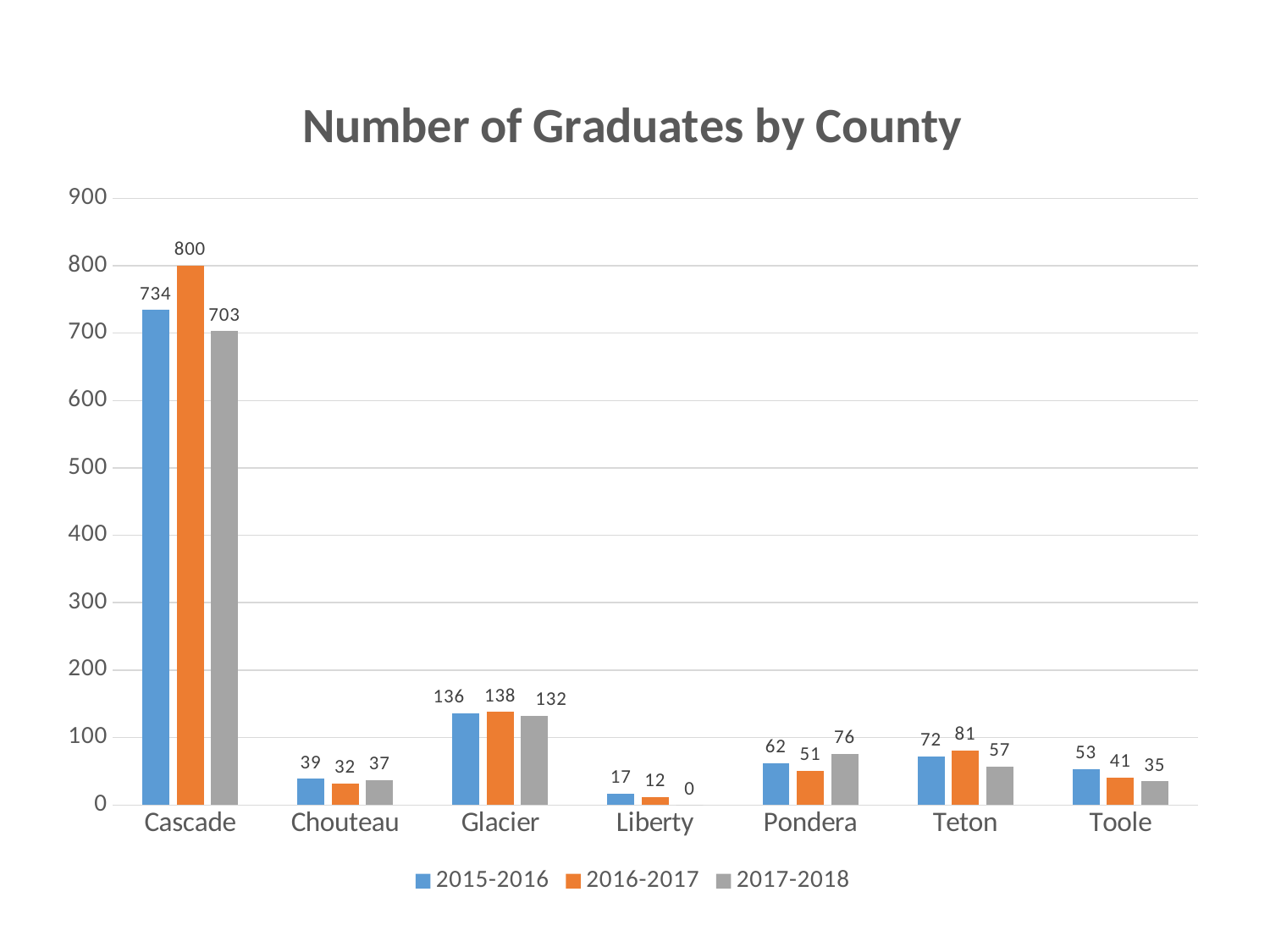
Which county has the lowest number of graduates in 2016-2017? Liberty Which county has the highest number of graduates in 2017-2018? Cascade Is the value for Glacier in 2015-2016 greater or less than 200? less How many counties are shown on the x axis? 7 What kind of chart is shown on the slide? Bar chart What is the number of graduates for Liberty in 2017-2018? 0 What is the title of the chart? Number of Graduates by County Which is larger for Teton: the 2015-2016 value or the 2016-2017 value? 2016-2017 What is the number of graduates for Cascade in 2016-2017? 800 What is the difference between Cascade's 2016-2017 and 2017-2018 graduate counts? 97 What is the number of graduates for Pondera in 2015-2016? 62 How many series does the legend list? 3